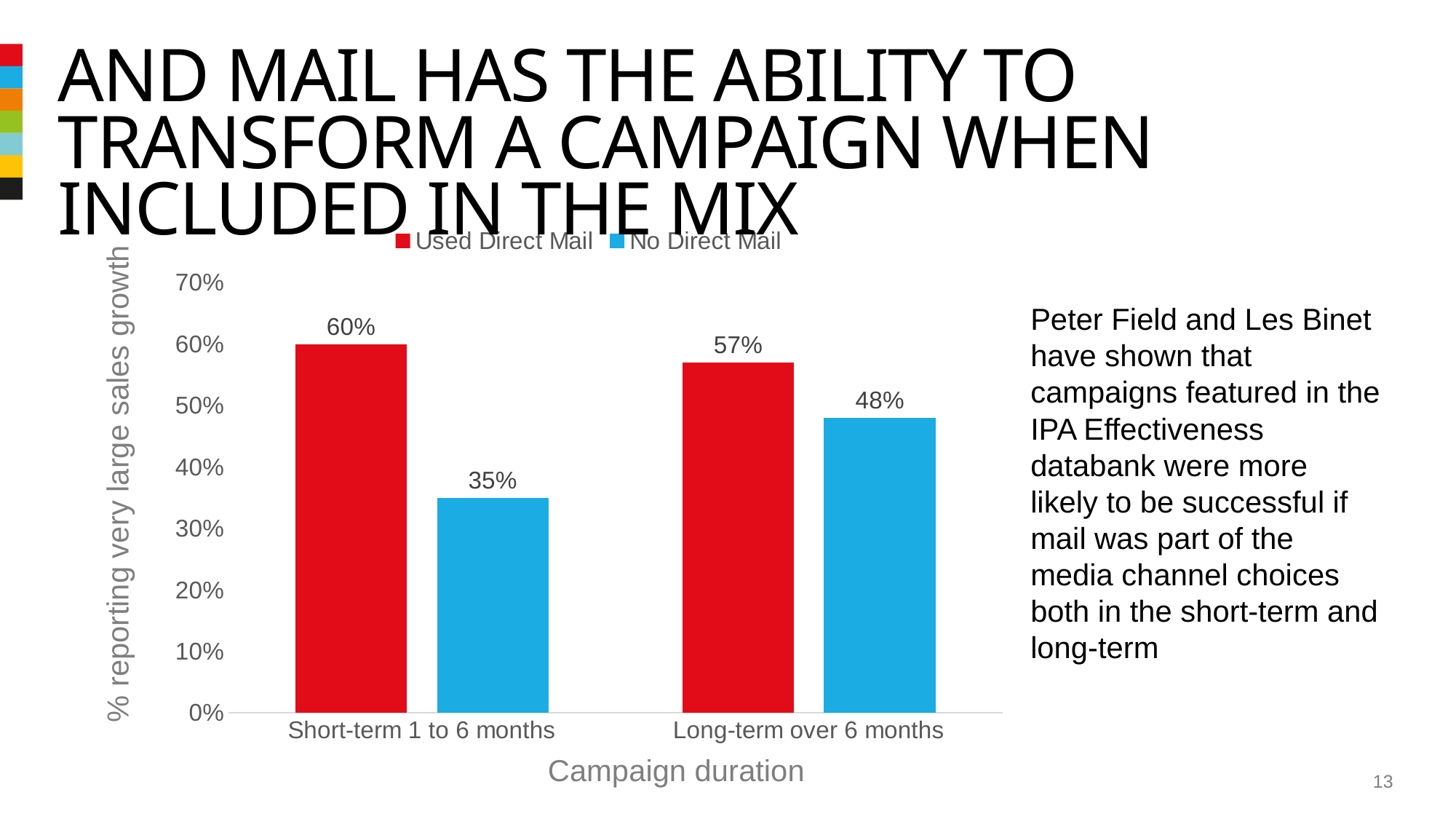
What is the difference between Used Direct Mail and No Direct Mail in the long-term category? 9% Which bar has the lowest value on the chart? No Direct Mail, Short-term 1 to 6 months What is the value for Used Direct Mail in the long-term (over 6 months) category? 57% How many campaign duration categories are shown on the x axis? 2 What is the value for No Direct Mail in the short-term (1 to 6 months) category? 35% What is the difference between Used Direct Mail and No Direct Mail in the short-term category? 25% What type of chart is shown on the slide? Bar chart How many series does the legend list? 2 Which is larger: No Direct Mail in the long-term category or No Direct Mail in the short-term category? Long-term over 6 months Which bar has the highest value on the chart? Used Direct Mail, Short-term 1 to 6 months What is the value for No Direct Mail in the long-term (over 6 months) category? 48% What percentage of campaigns that used direct mail reported very large sales growth in the short-term (1 to 6 months)? 60%